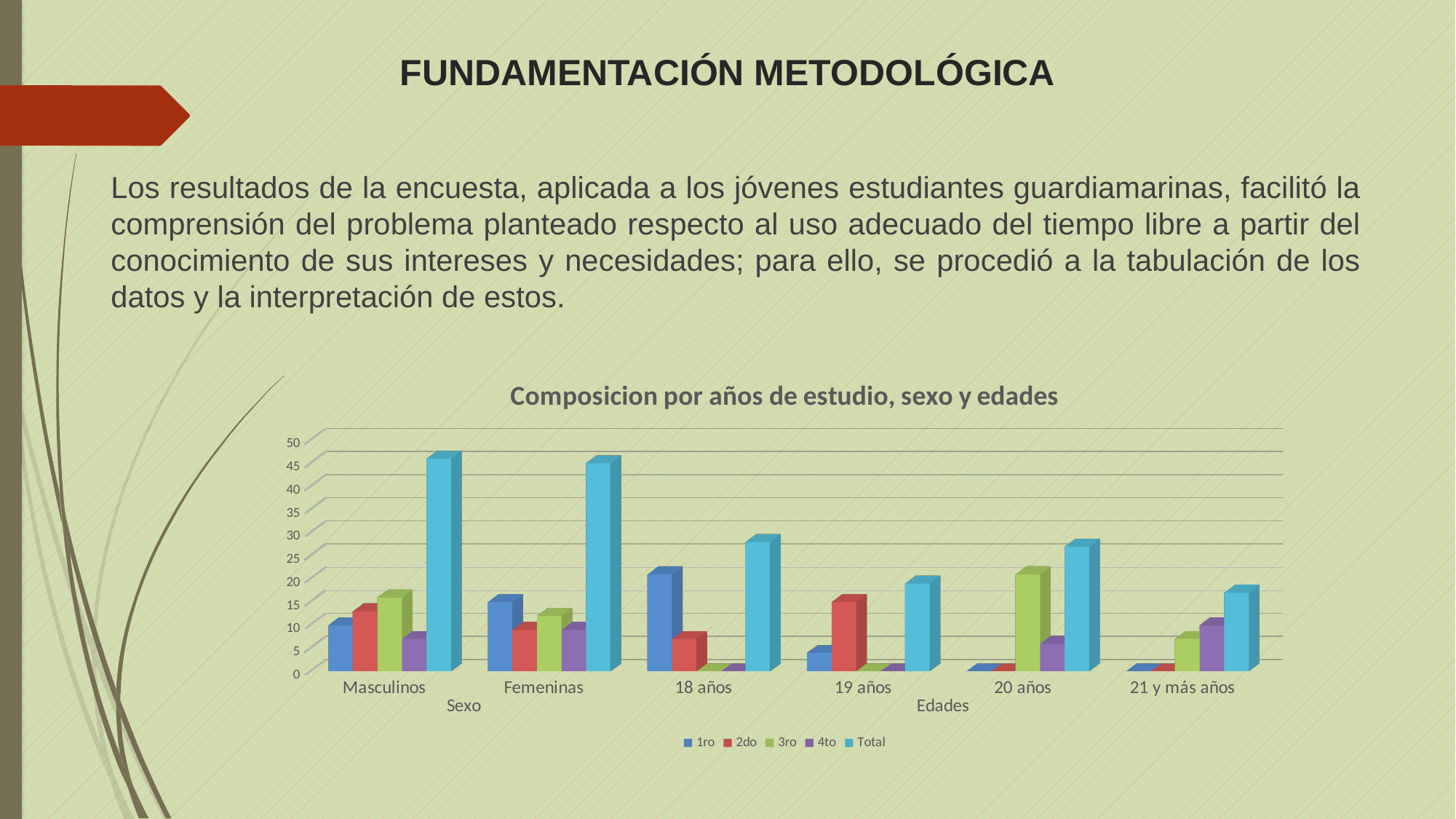
Which is larger, the 1ro value for 18 años or the 1ro value for 19 años? 18 años Is the Total value for 19 años greater or less than 25? less How many categories are shown along the x axis of the chart? 6 Is the 3ro value for 20 años greater or less than 15? greater Is the Total value for 21 y más años greater or less than 20? less How many series does the chart legend list? 5 What is the title of the chart? Composicion por años de estudio, sexo y edades Which series are listed in the chart legend? 1ro, 2do, 3ro, 4to, Total Which is larger, the Total value for 18 años or the Total value for 19 años? 18 años What type of chart is shown on the slide? bar chart